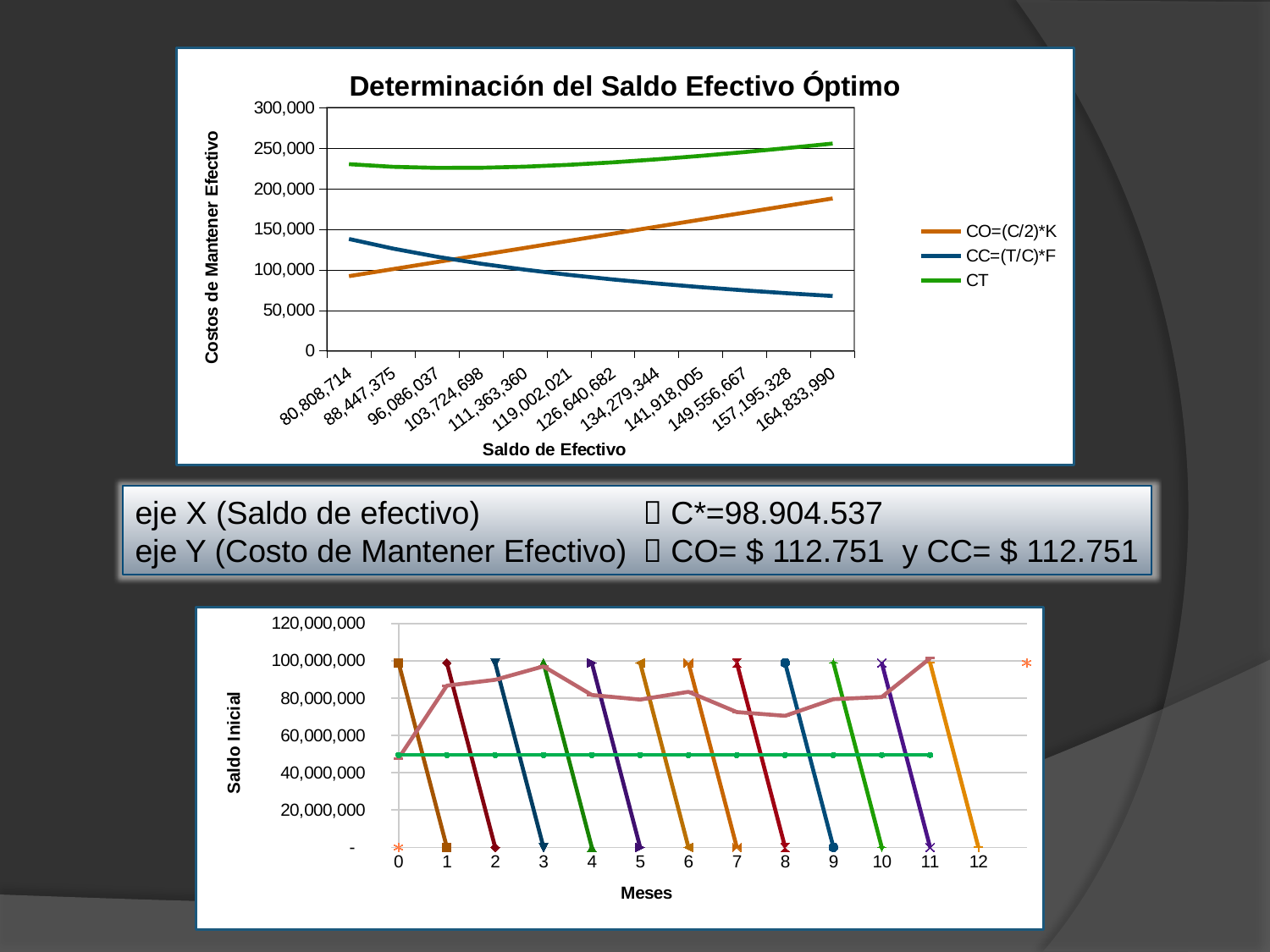
In the chart titled 'Determinación del Saldo Efectivo Óptimo', does the CC=(T/C)*F series rise or fall as Saldo de Efectivo increases? falls In the chart titled 'Determinación del Saldo Efectivo Óptimo', is the CC=(T/C)*F value at 164,833,990 greater or less than 100,000? less In the chart titled 'Determinación del Saldo Efectivo Óptimo', which series has the highest values across the whole x axis? CT In the chart titled 'Determinación del Saldo Efectivo Óptimo', how many series does the legend list? 3 In the chart titled 'Determinación del Saldo Efectivo Óptimo', what kind of chart is shown? line chart In the chart titled 'Determinación del Saldo Efectivo Óptimo', what is the title of the x axis? Saldo de Efectivo In the chart titled 'Determinación del Saldo Efectivo Óptimo', at 80,808,714 which is larger, CO=(C/2)*K or CC=(T/C)*F? CC=(T/C)*F In the chart titled 'Determinación del Saldo Efectivo Óptimo', does the CO=(C/2)*K series rise or fall as Saldo de Efectivo increases? rises In the chart titled 'Determinación del Saldo Efectivo Óptimo', at 164,833,990 which is larger, CO=(C/2)*K or CC=(T/C)*F? CO=(C/2)*K In the bottom chart on the slide, what is the title of the y axis? Saldo Inicial In the chart titled 'Determinación del Saldo Efectivo Óptimo', is the CT value at 80,808,714 greater or less than 200,000? greater In the chart titled 'Determinación del Saldo Efectivo Óptimo', how many categories are shown on the x axis? 12